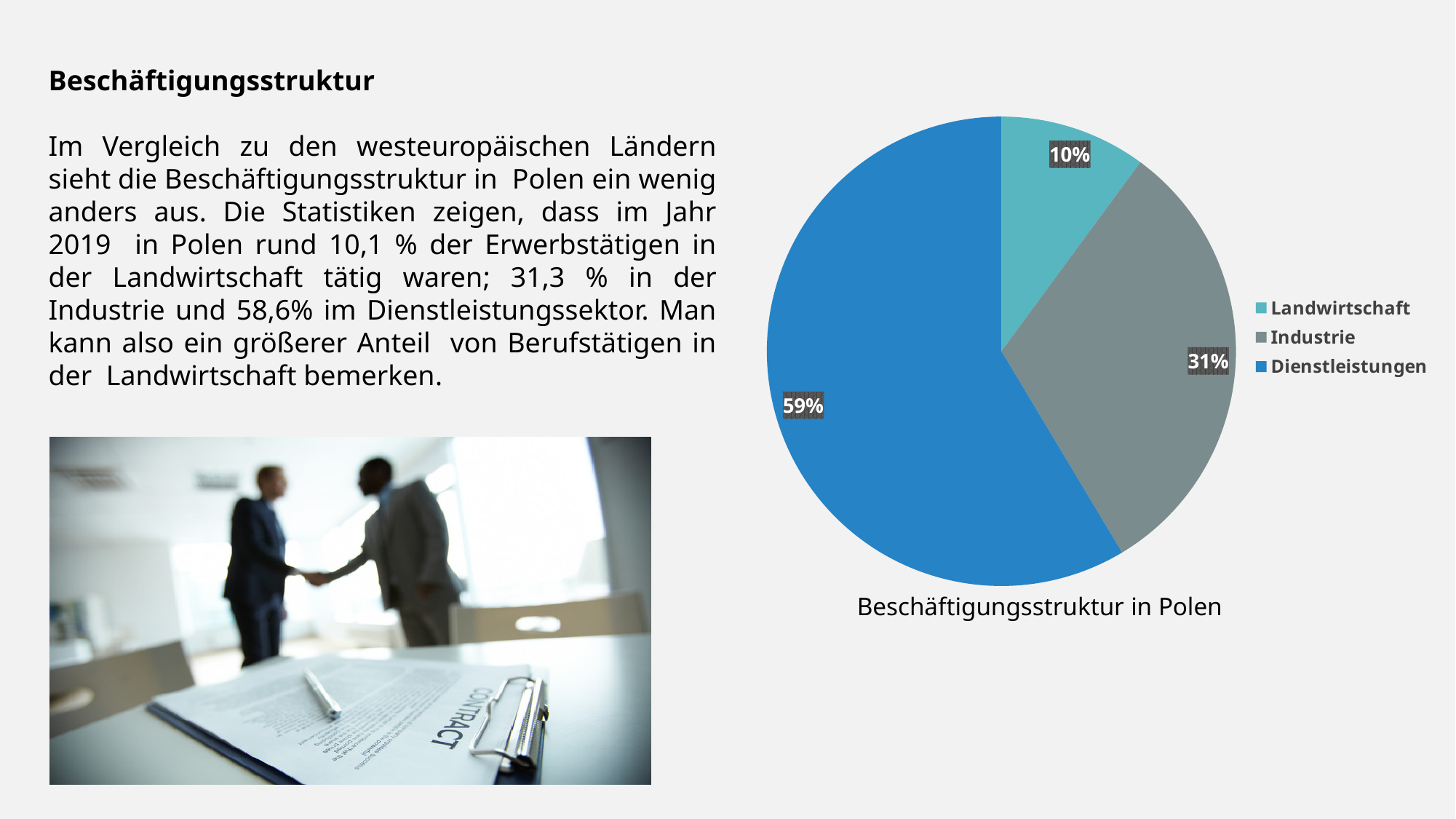
What percentage does the Landwirtschaft slice show? 10% What type of chart is shown on the slide? pie chart Which category has the largest share of the pie? Dienstleistungen Which category has the smallest share of the pie? Landwirtschaft How many entries does the legend list? 3 What percentage does the Dienstleistungen slice show? 59% How many slices does the pie chart have? 3 Which colour represents Dienstleistungen in the chart? blue What is the difference in percentage points between the Dienstleistungen and Industrie slices? 28 Which is larger, the Industrie slice or the Landwirtschaft slice? Industrie What is the title of the chart? Beschäftigungsstruktur in Polen What percentage does the Industrie slice show? 31%